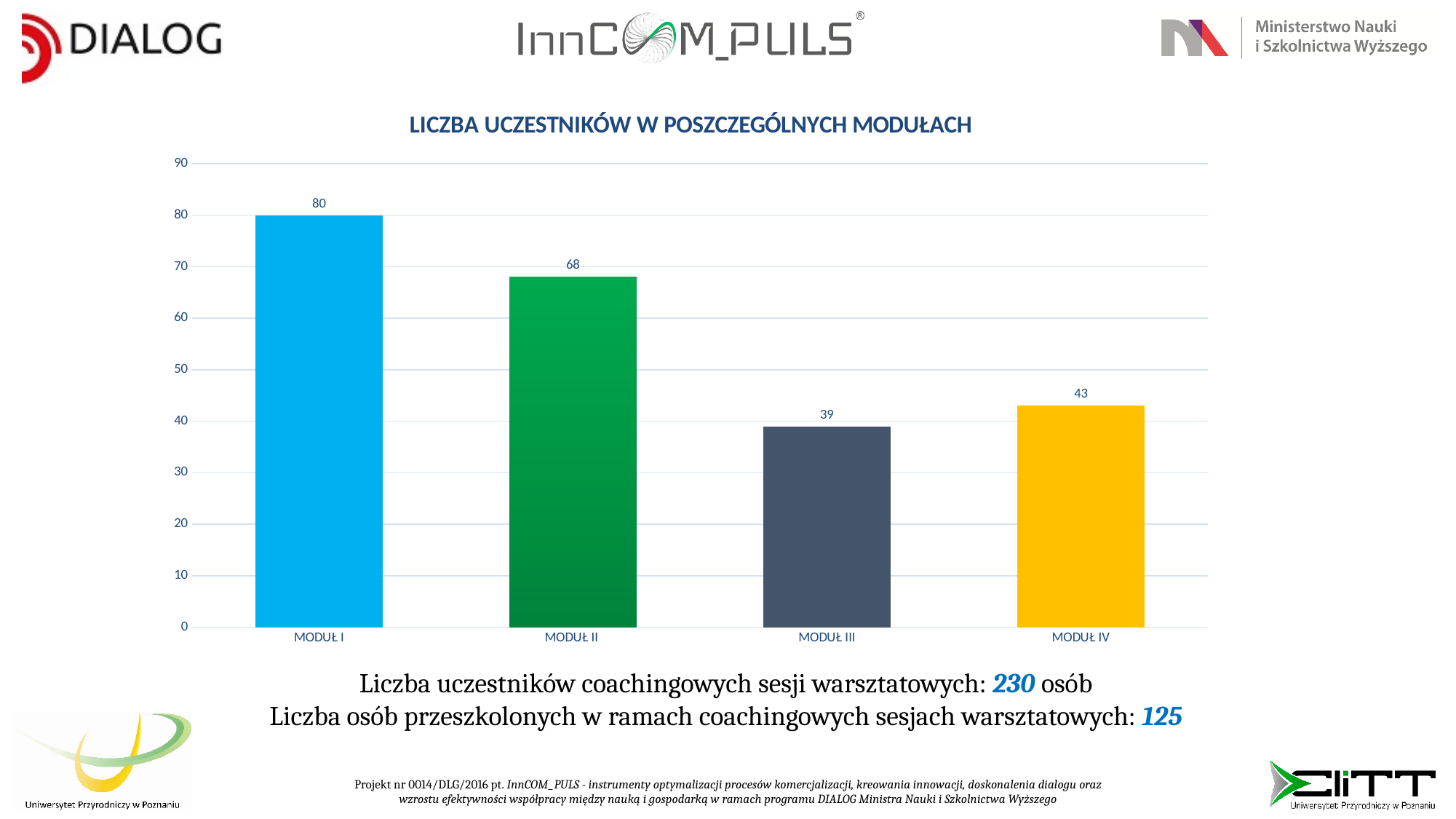
Is the value for MODUŁ II greater or less than 60? greater What is the value for MODUŁ I? 80 What is the difference between the values for MODUŁ IV and MODUŁ III? 4 Which module has the highest number of participants? MODUŁ I What is the value for MODUŁ III? 39 What is the title of the chart? LICZBA UCZESTNIKÓW W POSZCZEGÓLNYCH MODUŁACH How many modules are shown on the chart? 4 What kind of chart is shown on the slide? bar chart Which is larger, the value for MODUŁ II or the value for MODUŁ IV? MODUŁ II What is the value for MODUŁ IV? 43 Which module has the lowest number of participants? MODUŁ III What is the difference between the values for MODUŁ I and MODUŁ II? 12